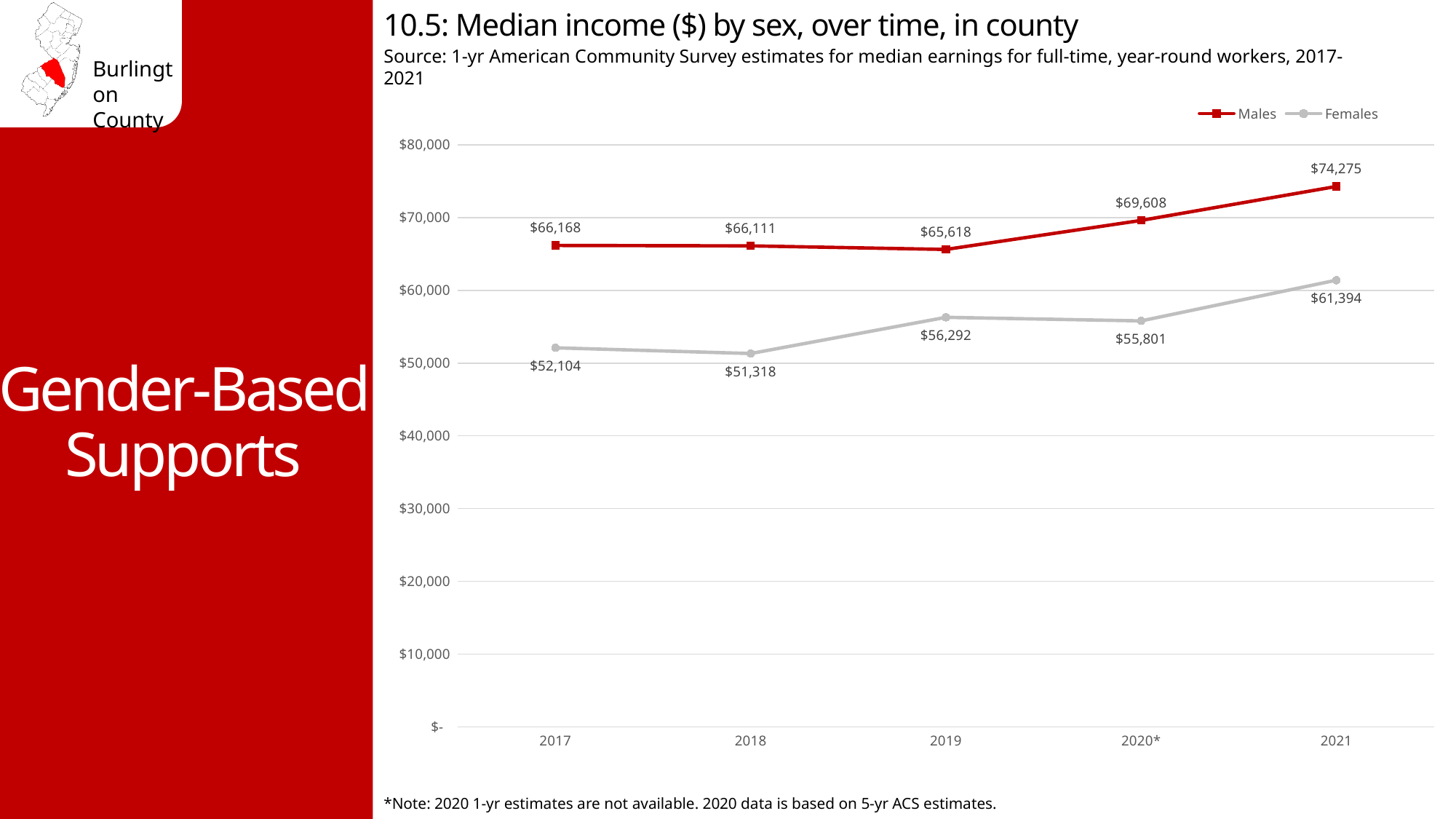
Is the Females median income in 2021 greater or less than $60,000? greater How many series does the legend list? 2 What was the median income for Females in 2019? $56,292 In which year was the Females median income lowest? 2018 What is the difference between the Males and Females median income in 2021? $12,881 What was the median income for Males in 2021? $74,275 Which was larger in 2020*, the Males median income or the Females median income? Males Did the Males median income rise or fall from 2019 to 2021? Rise How many years are shown on the x axis? 5 What kind of chart is shown on the slide? Line chart What was the median income for Females in 2017? $52,104 In which year was the Males median income highest? 2021